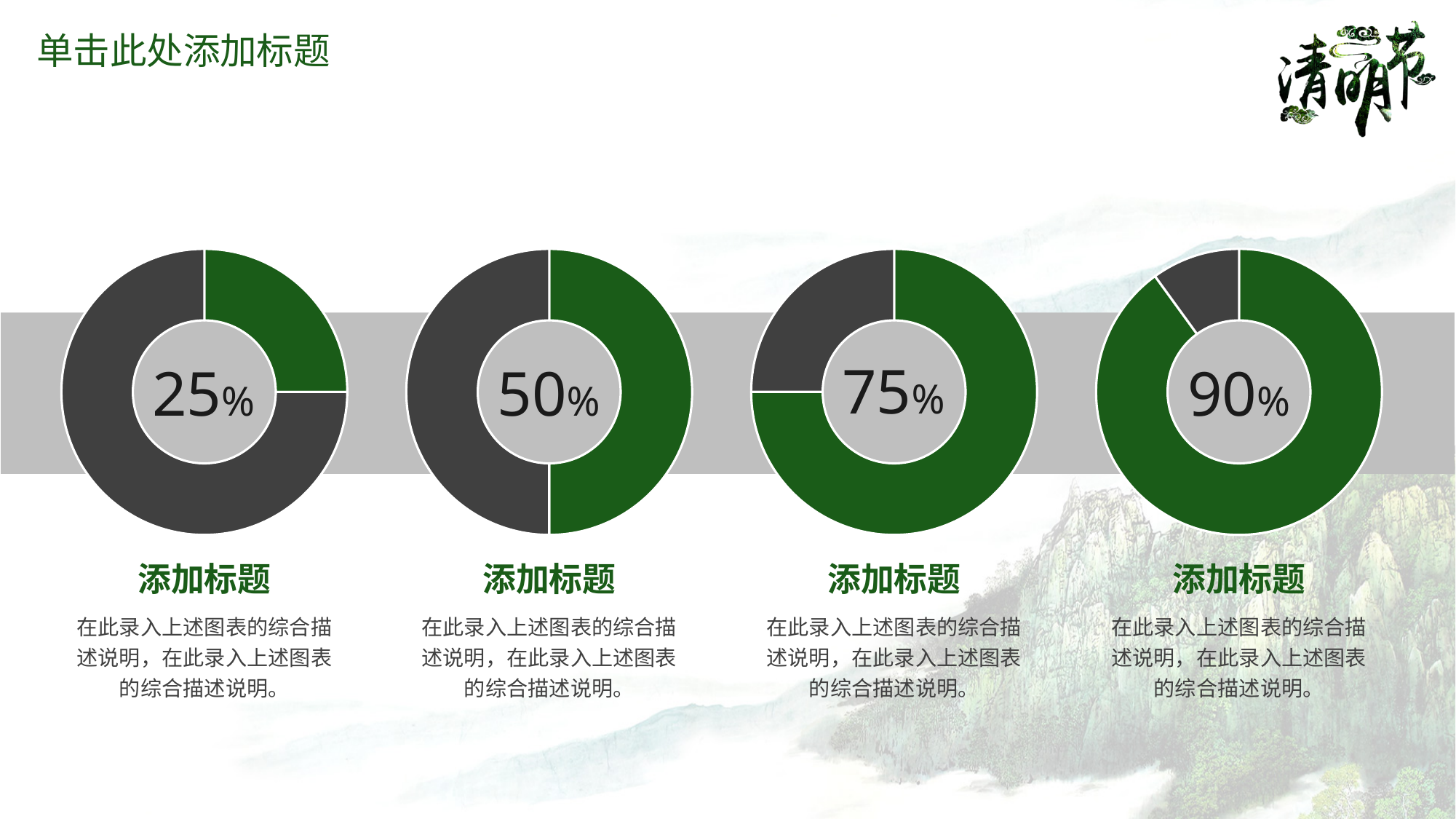
What kind of chart is used to display the percentages on the slide? Donut chart Which is larger: the percentage in the second donut chart from the left or the percentage in the third donut chart from the left? The third (75%) What value is shown in the centre of the second donut chart from the left? 50% Which donut chart shows the lowest percentage? The leftmost one (25%) What value is shown in the centre of the rightmost donut chart? 90% What is the difference between the percentage in the rightmost donut chart and the percentage in the leftmost donut chart? 65% What value is shown in the centre of the third donut chart from the left? 75% Do the percentages in the donut charts increase or decrease from left to right across the slide? Increase What colour is the filled (percentage) portion of each donut chart? Green What value is shown in the centre of the leftmost donut chart? 25% Which donut chart shows the highest percentage? The rightmost one (90%) How many donut charts are on the slide? 4